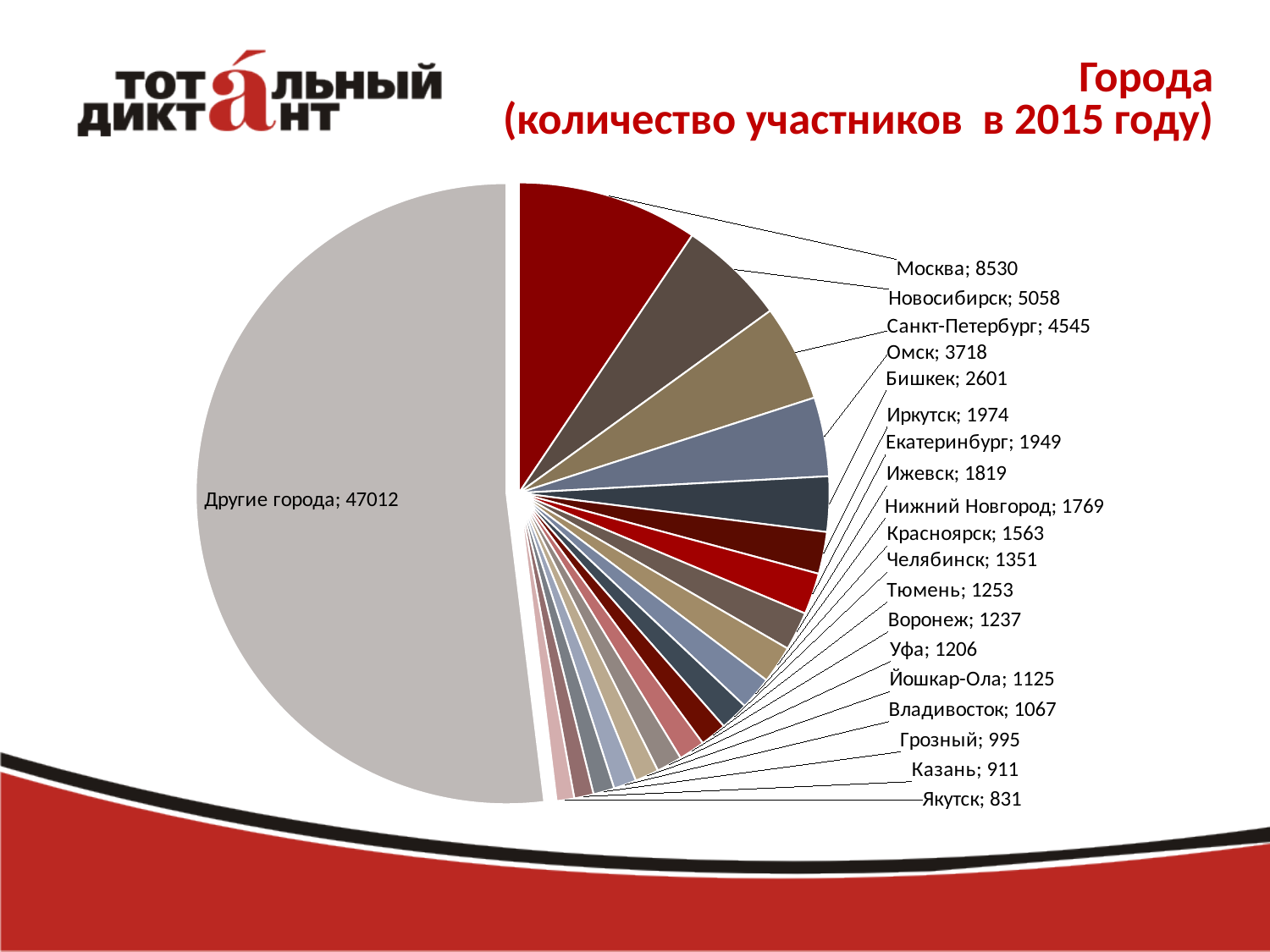
Which has more participants, Санкт-Петербург or Омск? Санкт-Петербург Which slice of the pie chart has the largest value? Другие города Which named city (excluding Другие города) has the highest number of participants? Москва Which slice of the pie chart has the smallest value? Якутск How many participants did Москва have in 2015 according to the chart? 8530 What is the title of the chart on the slide? Города (количество участников в 2015 году) What kind of chart is shown on the slide? Pie chart What is the value shown for Якутск? 831 What is the value shown for Новосибирск? 5058 How many slices does the pie chart have? 20 What is the value shown for Другие города? 47012 What is the difference between the values for Москва and Новосибирск? 3472